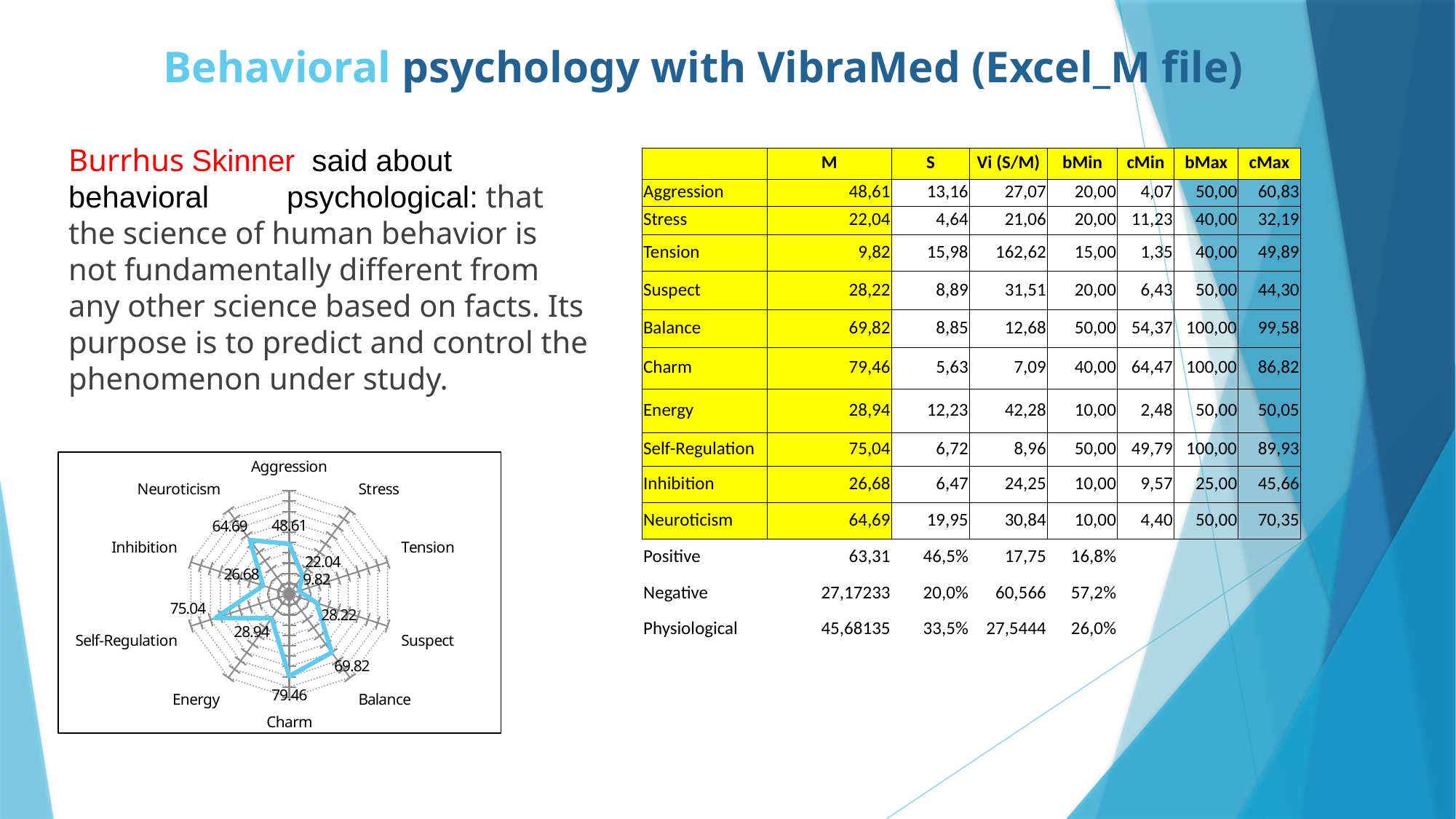
What is the value plotted for Aggression on the radar chart? 48.61 Which category has the highest value on the radar chart? Charm What is the value plotted for Self-Regulation on the radar chart? 75.04 What is the difference between the values for Self-Regulation and Balance on the radar chart? 5.22 How many categories are plotted on the radar chart? 10 Which category is positioned at the top of the radar chart? Aggression What is the difference between the values for Charm and Tension on the radar chart? 69.64 What is the value plotted for Energy on the radar chart? 28.94 What kind of chart is shown on the slide? Radar chart Which category has the lowest value on the radar chart? Tension What is the value plotted for Neuroticism on the radar chart? 64.69 On the radar chart, which is larger: the value for Stress or the value for Suspect? Suspect